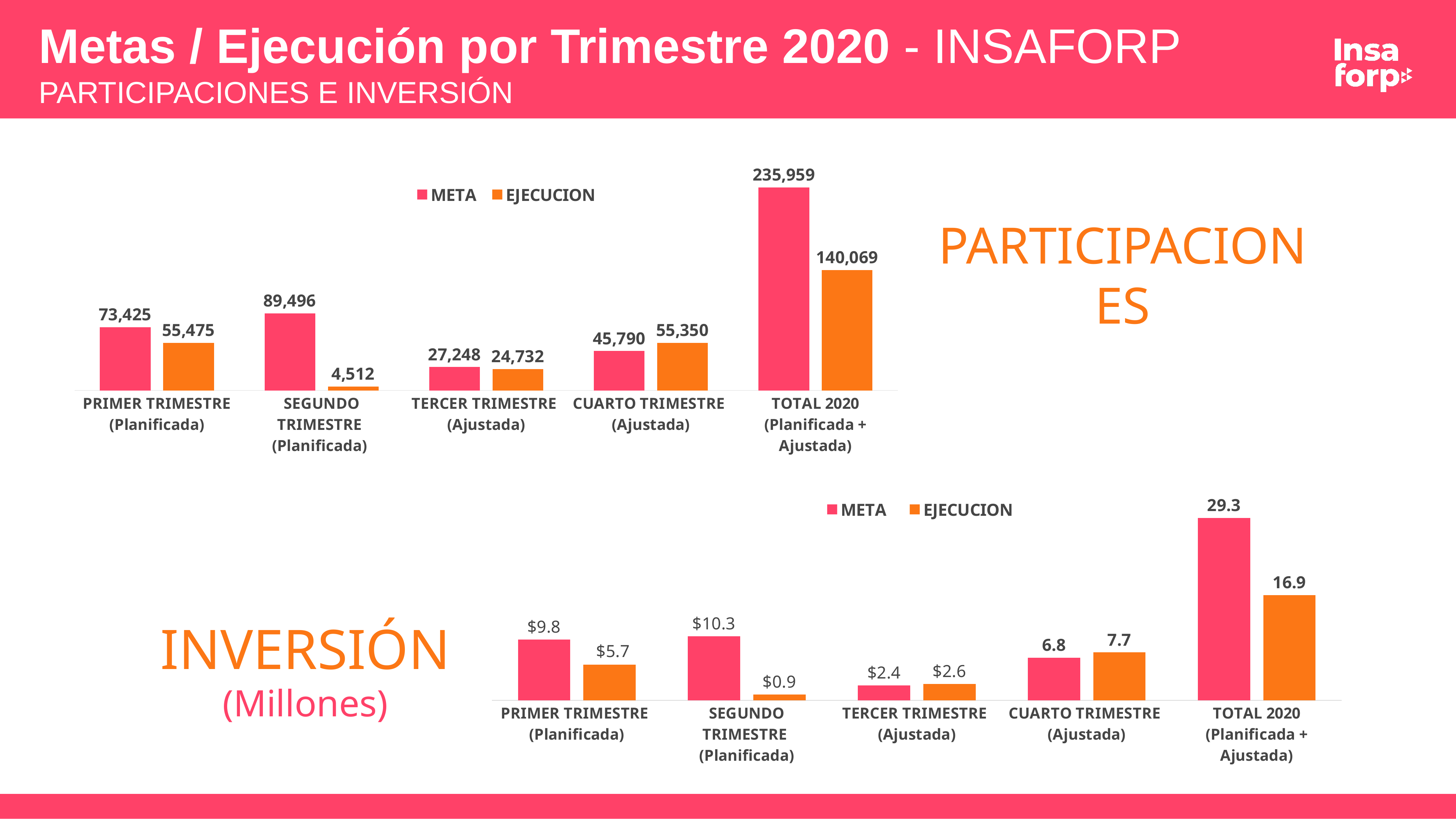
In the PARTICIPACIONES chart, what is the EJECUCION value for SEGUNDO TRIMESTRE (Planificada)? 4,512 In the PARTICIPACIONES chart, which quarter has the lowest EJECUCION value? SEGUNDO TRIMESTRE (Planificada) In the PARTICIPACIONES chart, what is the META value for PRIMER TRIMESTRE (Planificada)? 73,425 In the INVERSIÓN (Millones) chart, which quarter has the lowest EJECUCION value? SEGUNDO TRIMESTRE (Planificada) In the INVERSIÓN (Millones) chart, what is the EJECUCION value for TOTAL 2020 (Planificada + Ajustada)? 16.9 In the PARTICIPACIONES chart, what is the EJECUCION value for TOTAL 2020 (Planificada + Ajustada)? 140,069 In the INVERSIÓN (Millones) chart, what is the difference between META and EJECUCION for PRIMER TRIMESTRE (Planificada)? $4.1 What kind of chart is the PARTICIPACIONES chart? Bar chart In the PARTICIPACIONES chart, for CUARTO TRIMESTRE (Ajustada), which is larger, META or EJECUCION? EJECUCION In the PARTICIPACIONES chart, what is the difference between META and EJECUCION for TOTAL 2020? 95,890 How many series does the legend of the INVERSIÓN (Millones) chart list? 2 In the INVERSIÓN (Millones) chart, what is the META value for SEGUNDO TRIMESTRE (Planificada)? $10.3